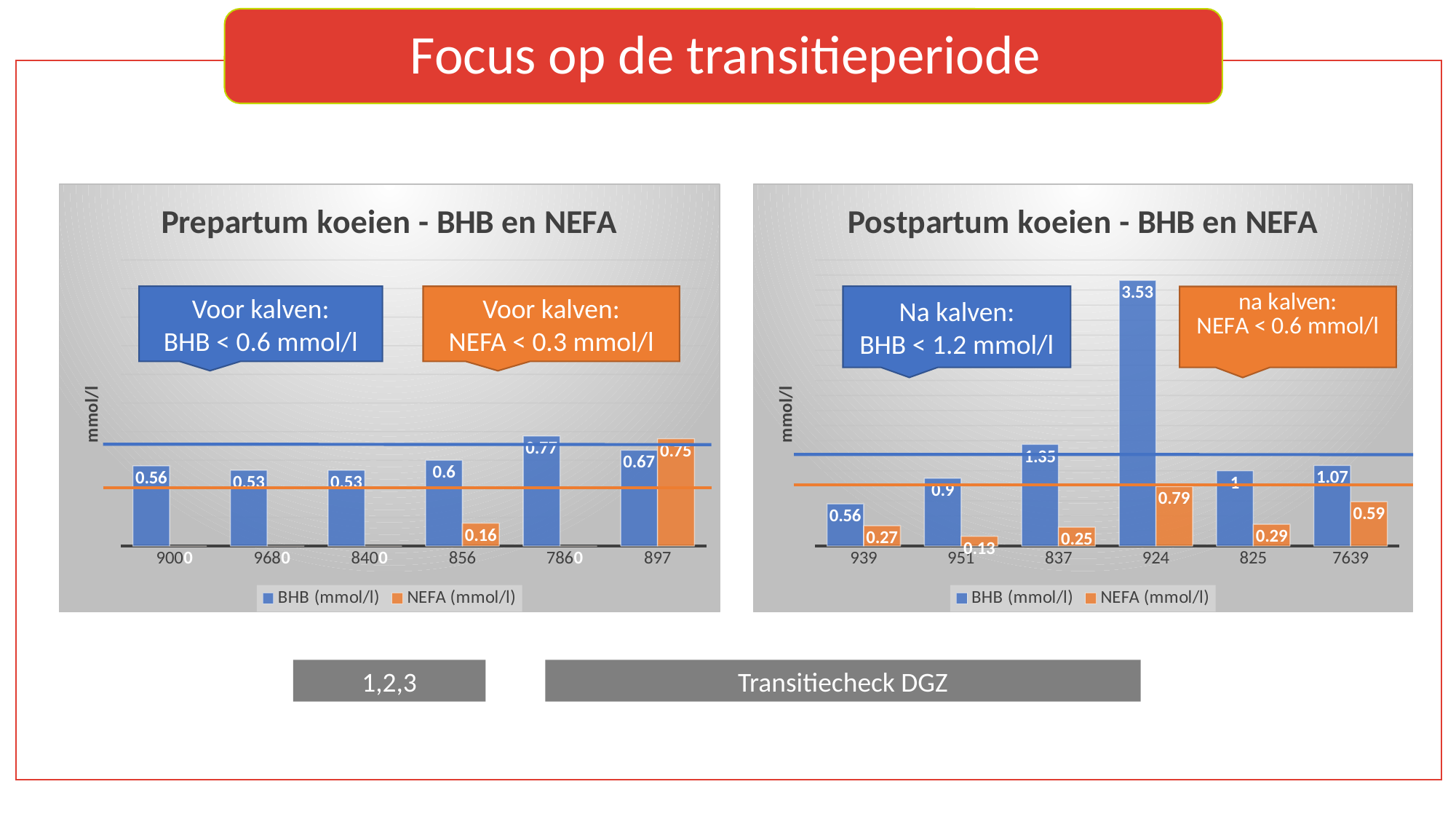
How many series does the legend of the Prepartum koeien - BHB en NEFA chart list? 2 How many cows (categories) are shown in the Postpartum koeien - BHB en NEFA chart? 6 In the Prepartum koeien - BHB en NEFA chart, which cow has the highest BHB value? 786 In the Prepartum koeien - BHB en NEFA chart, what is the NEFA value for cow 856? 0.16 What type of chart is the Prepartum koeien - BHB en NEFA chart? Bar chart In the Postpartum koeien - BHB en NEFA chart, what is the difference between the BHB values of cow 924 and cow 837? 2.18 In the Postpartum koeien - BHB en NEFA chart, what is the NEFA value for cow 7639? 0.59 In the Postpartum koeien - BHB en NEFA chart, what is the BHB value for cow 924? 3.53 In the Prepartum koeien - BHB en NEFA chart, what is the BHB value for cow 897? 0.67 In the Postpartum koeien - BHB en NEFA chart, which is larger: the NEFA value for cow 924 or for cow 825? 924 In the Postpartum koeien - BHB en NEFA chart, which cow has the highest BHB value? 924 In the Postpartum koeien - BHB en NEFA chart, which cow has the lowest NEFA value? 951